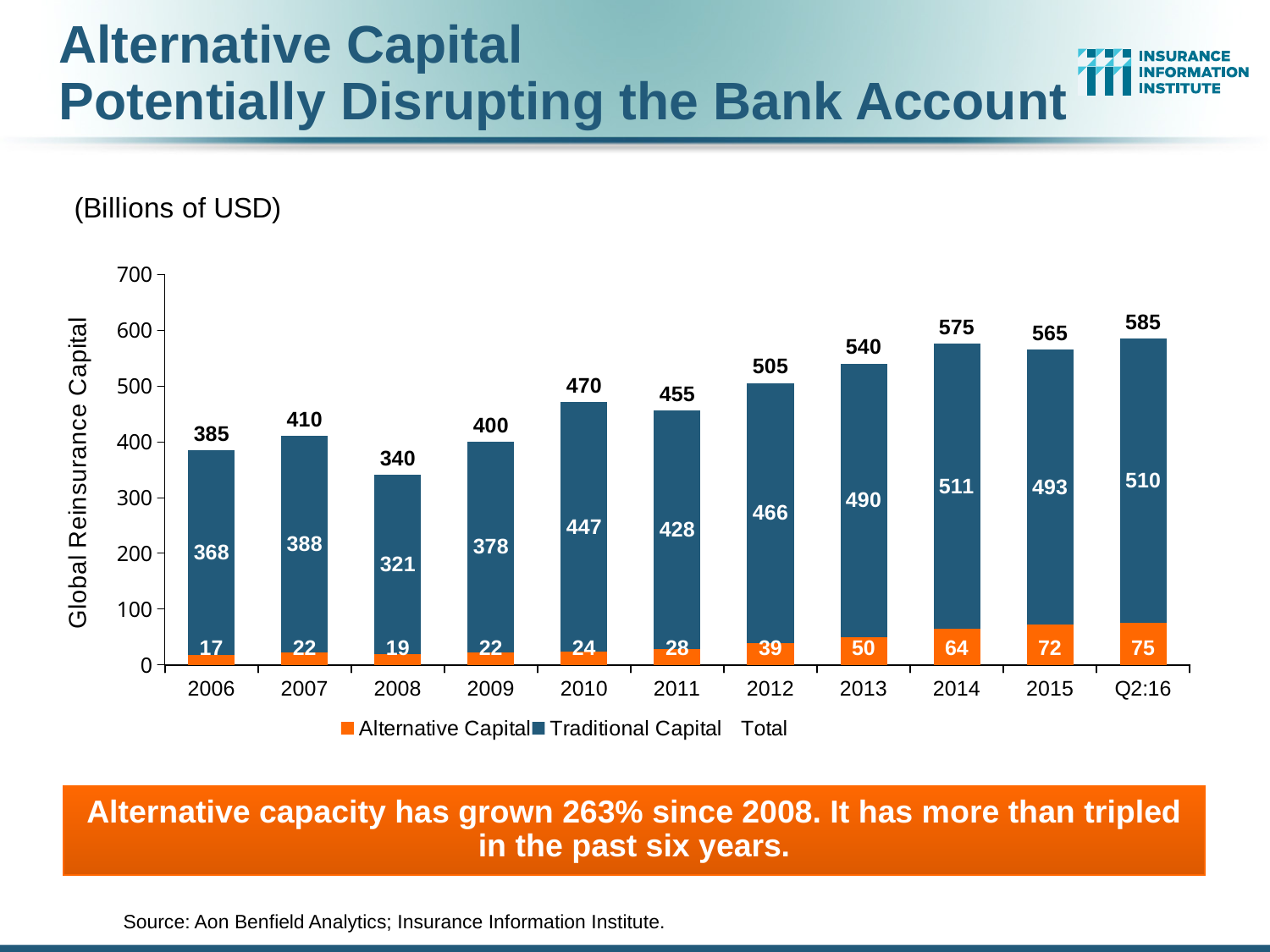
How many entries does the legend list? 3 What is the Total value shown for 2008? 340 What is the Alternative Capital value for 2012? 39 What is the Traditional Capital value for 2014? 511 Is the Total for 2013 greater or less than 500? greater Which category has the highest Alternative Capital value? Q2:16 What is the y-axis label of the chart? Global Reinsurance Capital What kind of chart is shown on the slide? Stacked bar chart How many categories are shown on the x axis? 11 Which is larger, the Traditional Capital value for 2010 or for 2011? 2010 What is the difference between the Total for Q2:16 and the Total for 2006? 200 Which year has the lowest Total global reinsurance capital? 2008